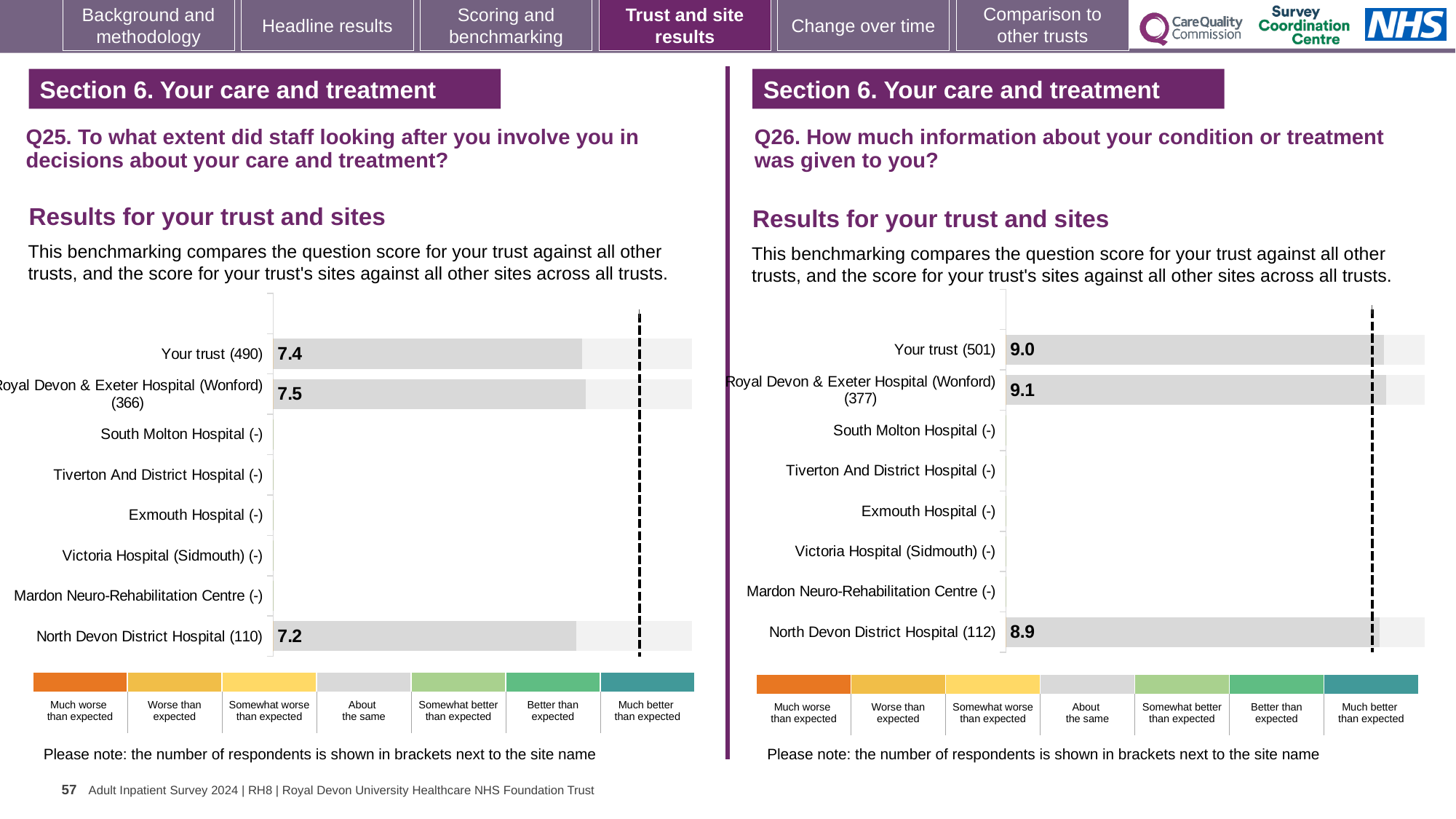
How many site/trust categories are listed on the Q25 chart (left)? 8 On the Q25 chart (left), what is the score for Royal Devon & Exeter Hospital (Wonford)? 7.5 On the Q25 chart (left), what is the score for North Devon District Hospital? 7.2 On the Q26 chart (right), which is larger: the score for Your trust or the score for North Devon District Hospital? Your trust On the Q25 chart (left), what is the difference between the scores for Royal Devon & Exeter Hospital (Wonford) and North Devon District Hospital? 0.3 On the Q25 chart (left), how many respondents are shown in brackets for Your trust? 490 On the Q26 chart (right), which site has the highest score? Royal Devon & Exeter Hospital (Wonford) On the Q25 chart (left), what is the score for Your trust? 7.4 On the Q26 chart (right), what is the score for North Devon District Hospital? 8.9 On the Q25 chart (left), which site with a printed score has the lowest score? North Devon District Hospital On the Q26 chart (right), what is the score for Your trust? 9.0 What kind of chart is used on the Q26 chart (right)? Bar chart